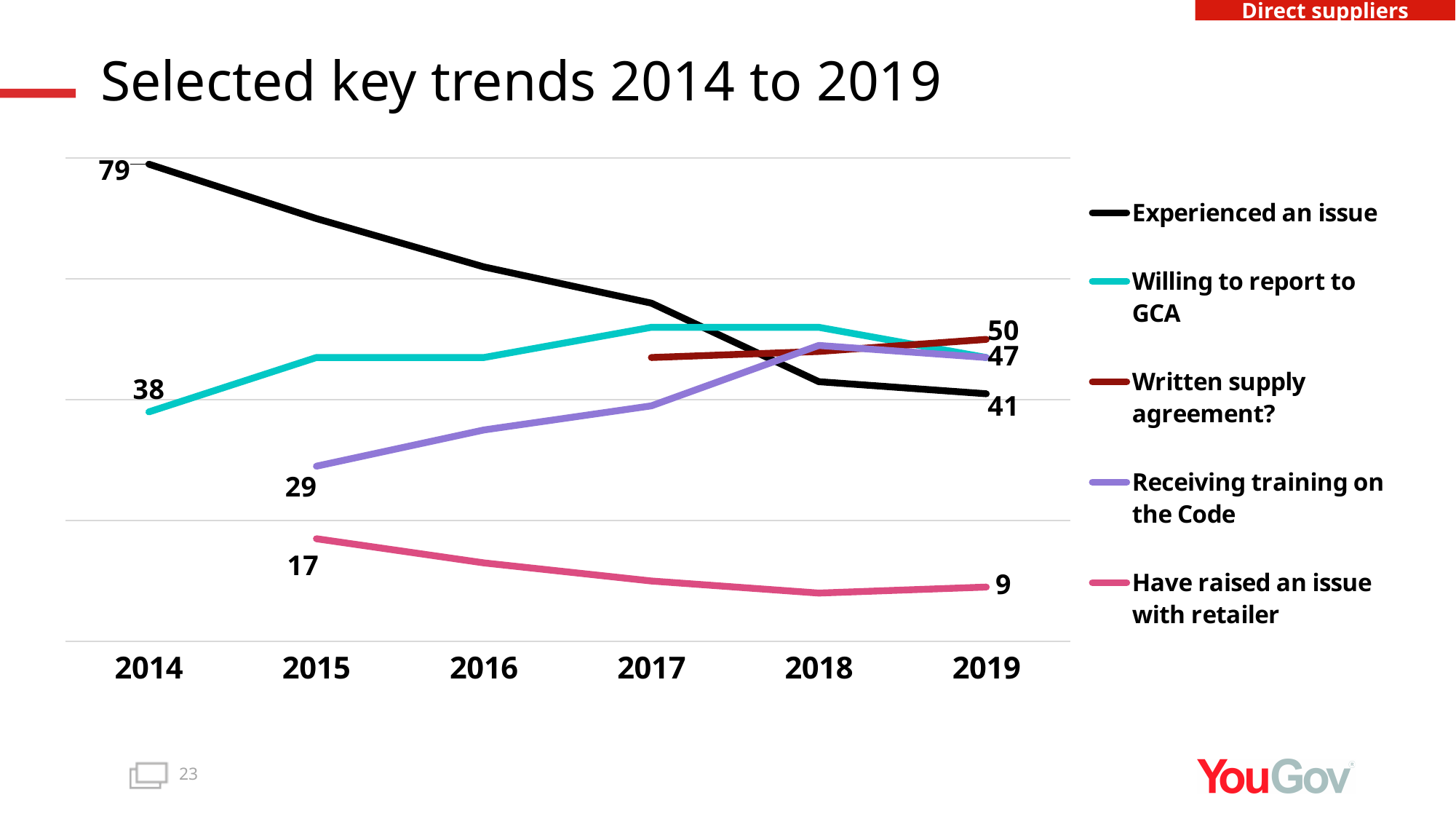
By how much did the value for Experienced an issue fall between 2014 and 2019? 38 What is the value for Experienced an issue in 2019? 41 Does the Experienced an issue line rise or fall from 2014 to 2019? fall What is the value for Written supply agreement? in 2019? 50 How many series does the legend list? 5 What is the difference between the 2015 and 2019 values for Have raised an issue with retailer? 8 What is the value for Have raised an issue with retailer in 2019? 9 What is the value for Receiving training on the Code in 2015? 29 Which series has the lowest value in 2019? Have raised an issue with retailer What kind of chart is shown on the slide? line chart What is the value for Willing to report to GCA in 2014? 38 What is the value for Experienced an issue in 2014? 79